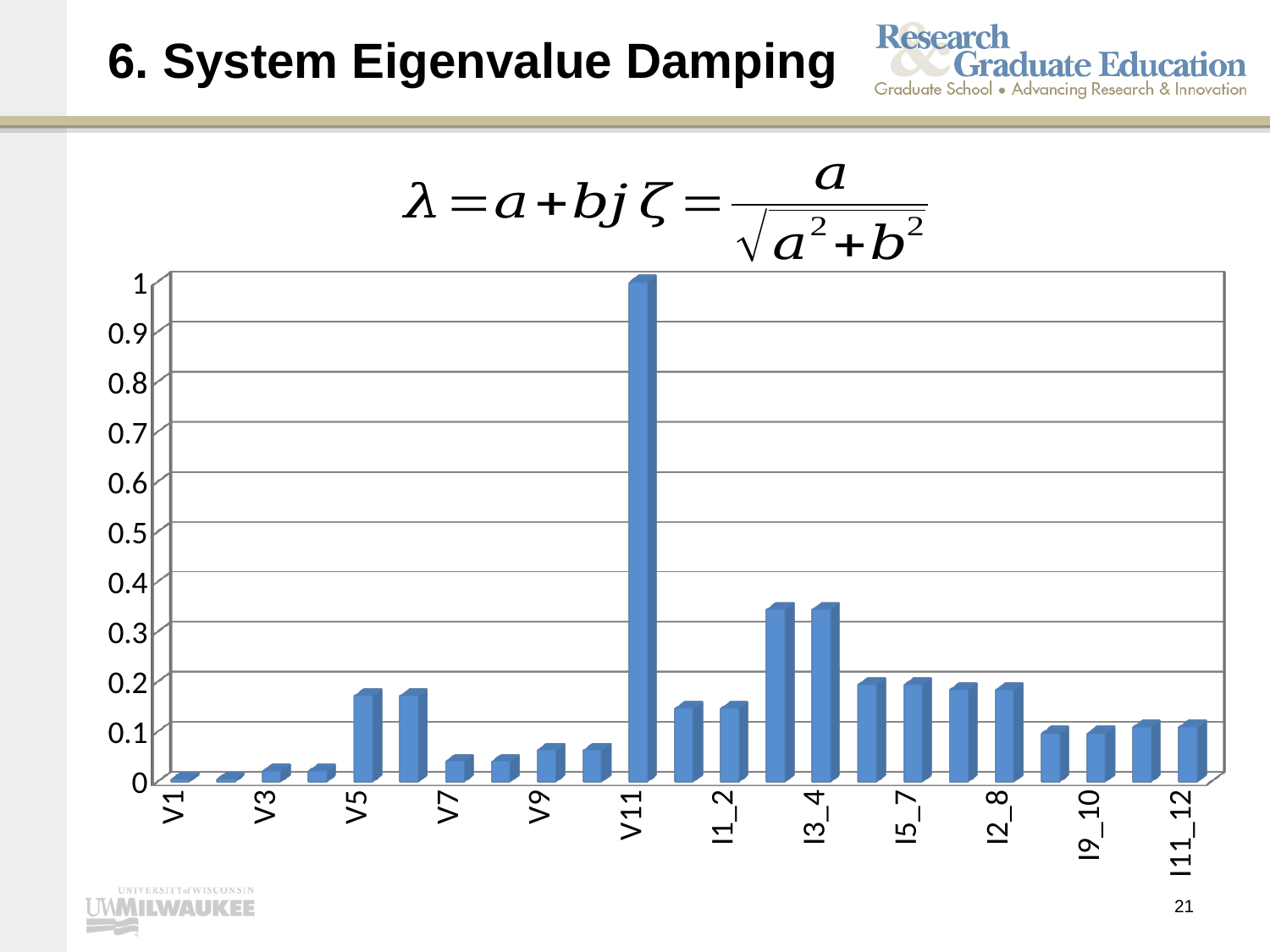
What kind of chart is shown on the slide? bar chart Is the value for V1 greater or less than 0.1? less Which category has the highest bar? V11 What is the value for V11? 1 What is the highest value shown on the vertical axis? 1 Which is larger, the value for V5 or the value for V7? V5 Which is larger, the value for I3_4 or the value for I5_7? I3_4 Which is larger, the value for V11 or the value for I3_4? V11 How many bars are plotted in the chart? 23 Is the value for I9_10 greater or less than 0.2? less Is the value for V5 greater or less than 0.1? greater